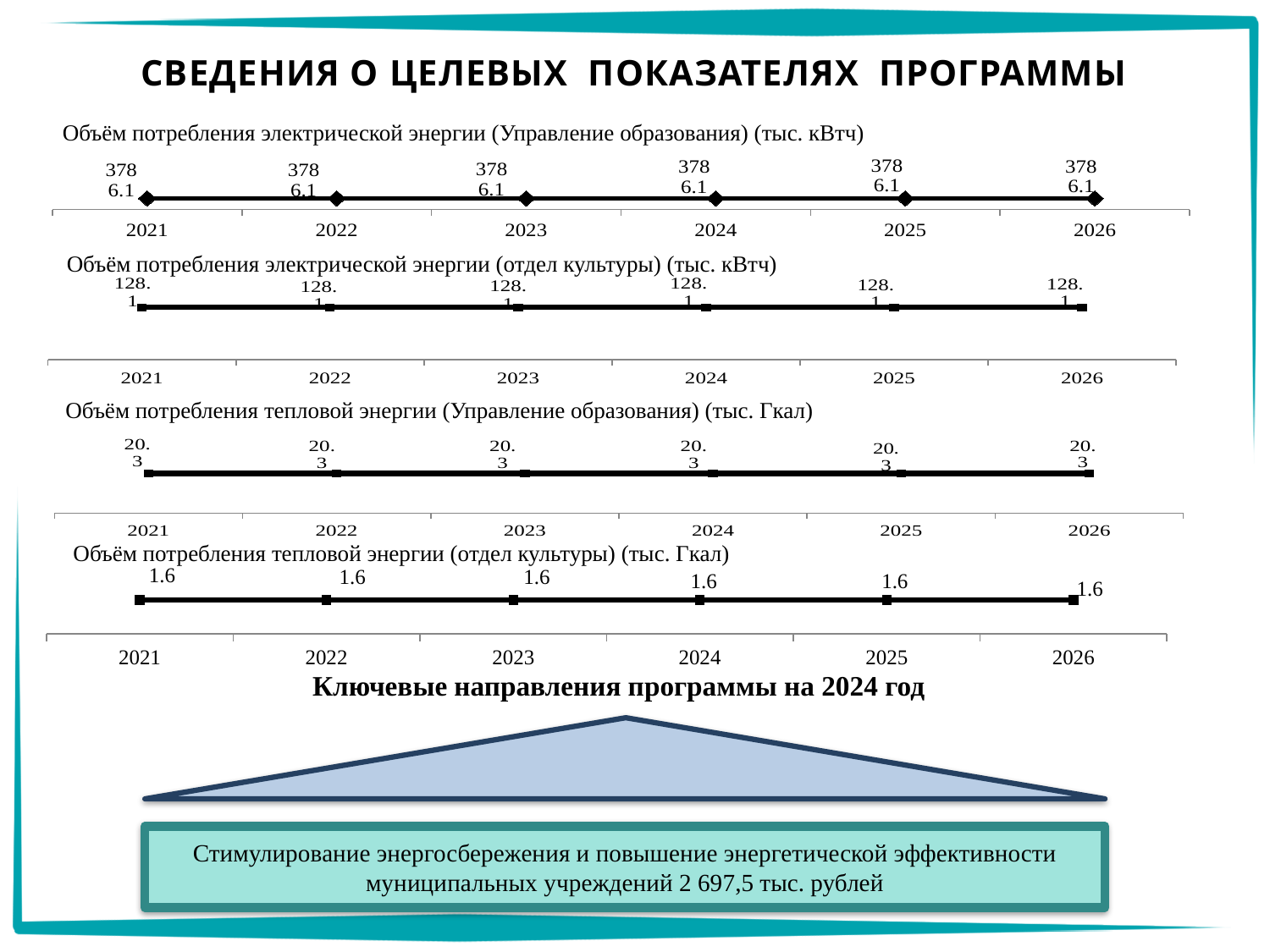
In the chart 'Объём потребления тепловой энергии (отдел культуры) (тыс. Гкал)', do the values rise, fall or stay the same from 2021 to 2026? stay the same In the chart 'Объём потребления электрической энергии (Управление образования) (тыс. кВтч)', do the values rise, fall or stay the same across the years? stay the same In the chart 'Объём потребления тепловой энергии (Управление образования) (тыс. Гкал)', what is the value for 2023? 20.3 In the chart 'Объём потребления электрической энергии (отдел культуры) (тыс. кВтч)', what is the value for 2025? 128.1 How many years are plotted on the x axis of the chart 'Объём потребления электрической энергии (Управление образования) (тыс. кВтч)'? 6 In the chart 'Объём потребления тепловой энергии (Управление образования) (тыс. Гкал)', is the value for 2022 larger than, smaller than or equal to the value for 2026? equal How many charts are shown on the slide? 4 What is the first year shown on the x axis of the chart 'Объём потребления электрической энергии (отдел культуры) (тыс. кВтч)'? 2021 In the chart 'Объём потребления тепловой энергии (отдел культуры) (тыс. Гкал)', what is the difference between the 2026 value and the 2021 value? 0 In the chart 'Объём потребления тепловой энергии (отдел культуры) (тыс. Гкал)', what is the value for 2021? 1.6 In the chart 'Объём потребления тепловой энергии (отдел культуры) (тыс. Гкал)', what is the value for 2024? 1.6 What type of chart is used for 'Объём потребления тепловой энергии (отдел культуры) (тыс. Гкал)'? line chart